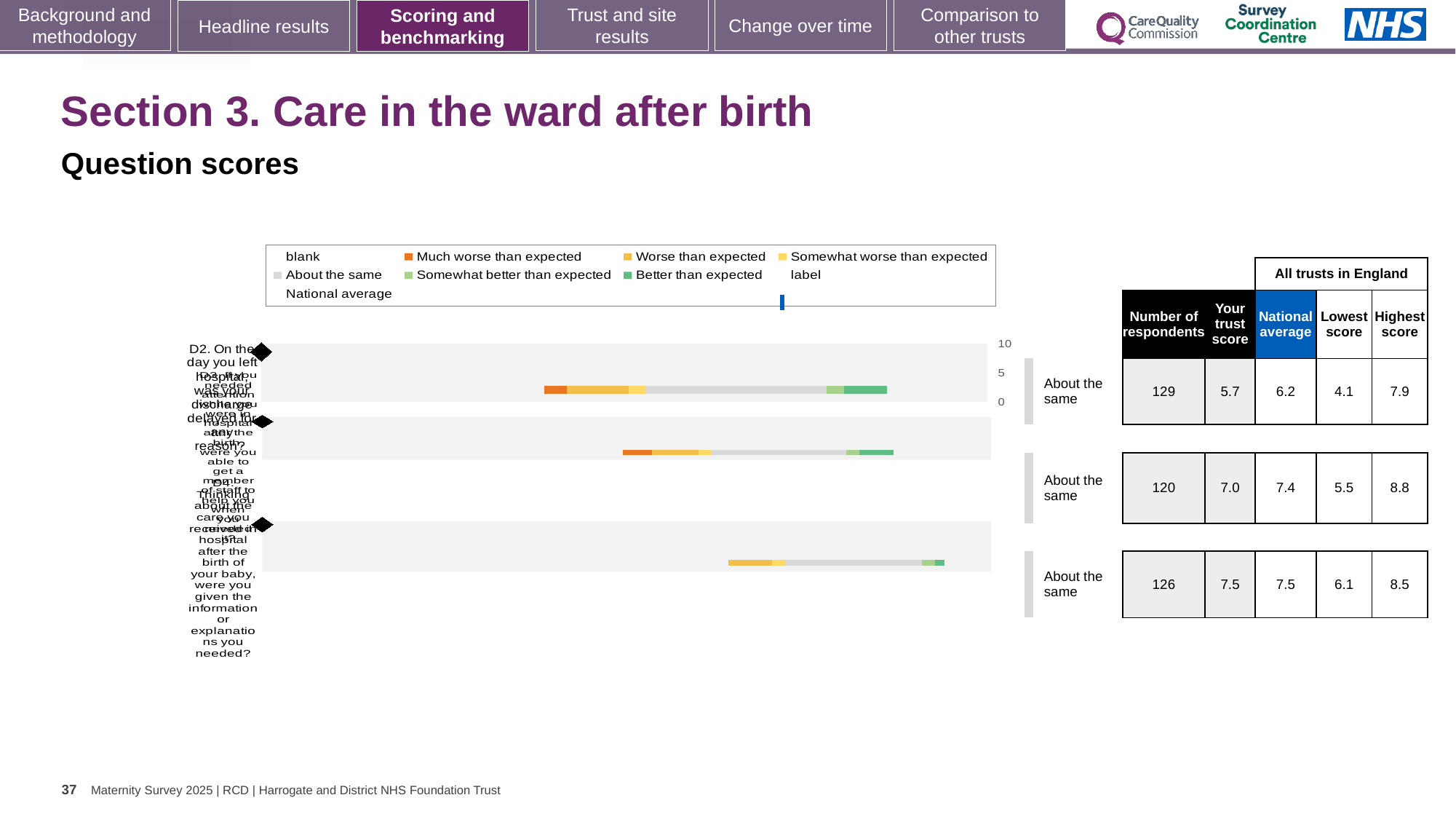
In the table on the right, what is the difference between the national average and your trust score in the first row? 0.5 In the table on the right, which row has the highest 'Highest score'? the second row (8.8) In the table on the right, what is 'Your trust score' for the second row? 7.0 In the chart legend, what colour represents 'Much worse than expected'? orange What benchmark category is shown next to each of the three bars? About the same How many stacked bars (questions) are plotted in the chart? 3 In the table on the right, for the second row, which is larger: your trust score or the national average? National average In the table on the right, what is the number of respondents for the first row? 129 In the chart legend, what does the dark blue vertical marker represent? National average In the table on the right, which row has the lowest 'Lowest score'? the first row (4.1) What kind of chart is shown on the slide? bar chart In the table on the right, what is the national average for the third row? 7.5